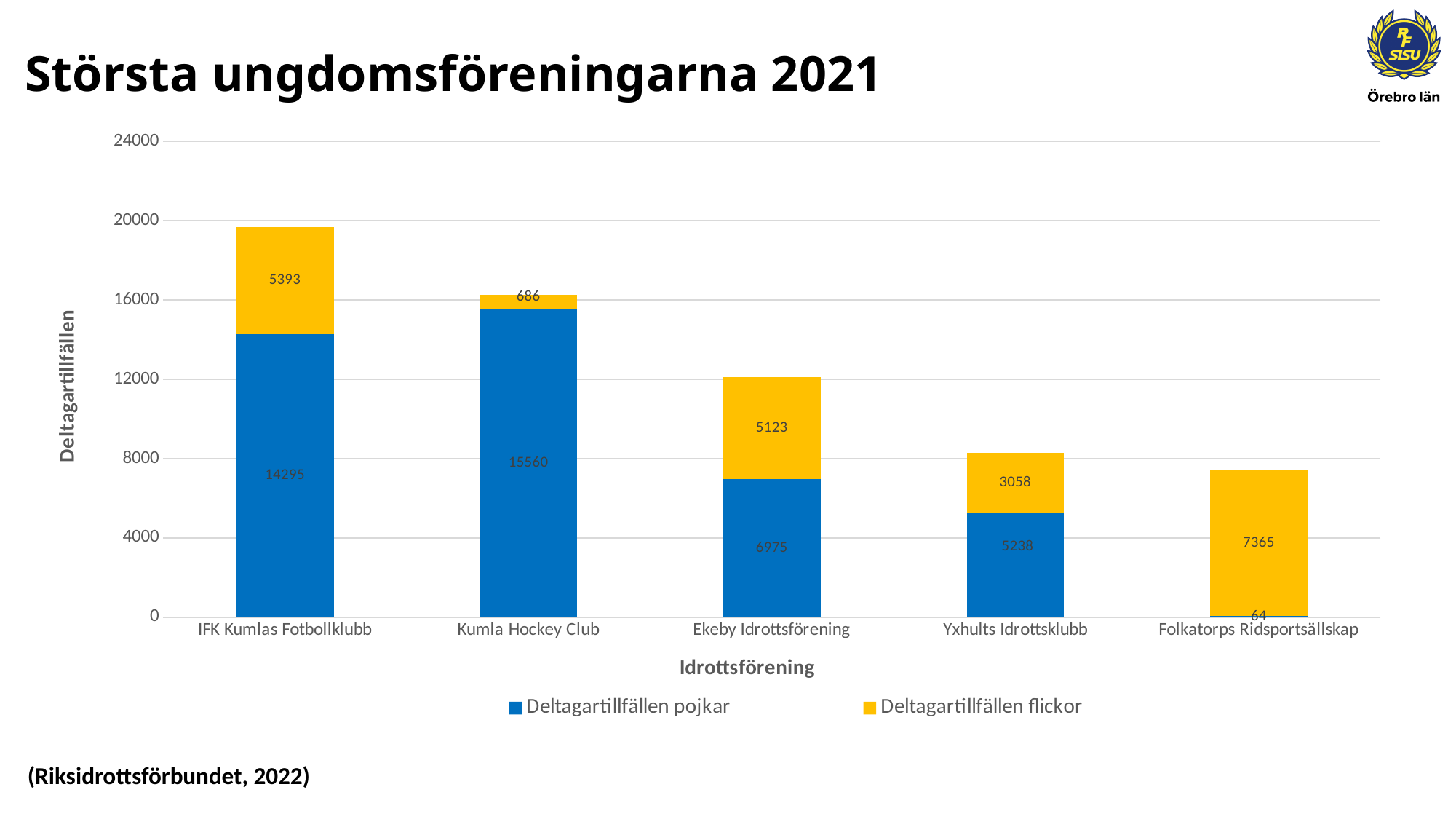
How many series does the legend list? 2 What is the value of Deltagartillfällen pojkar for IFK Kumlas Fotbollklubb? 14295 Which is larger: Deltagartillfällen flickor for IFK Kumlas Fotbollklubb or for Ekeby Idrottsförening? IFK Kumlas Fotbollklubb Which association has the lowest value for Deltagartillfällen flickor? Kumla Hockey Club What is the total of the stacked bar for Yxhults Idrottsklubb? 8296 How many associations are shown on the x axis? 5 What is the value of Deltagartillfällen flickor for Folkatorps Ridsportsällskap? 7365 What is the value of Deltagartillfällen flickor for Kumla Hockey Club? 686 What is the difference between Deltagartillfällen pojkar and Deltagartillfällen flickor for Ekeby Idrottsförening? 1852 Is the total stacked bar for Yxhults Idrottsklubb greater or less than 8000? greater Which association has the highest value for Deltagartillfällen pojkar? Kumla Hockey Club What kind of chart is shown on the slide? Stacked bar chart